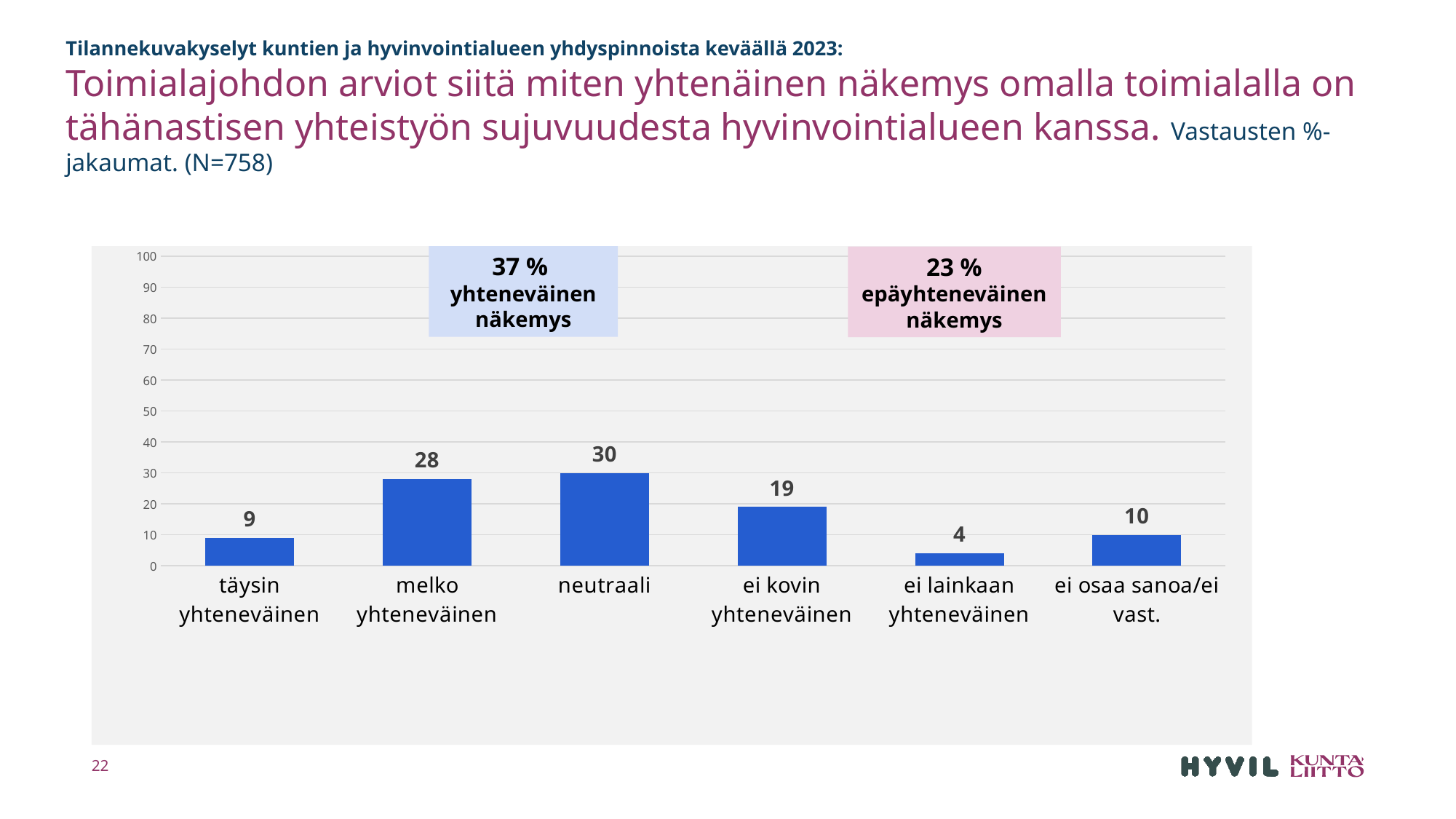
What is the value for "ei osaa sanoa/ei vast."? 10 What percentage does the pink box above the chart give for "epäyhteneväinen näkemys"? 23 % What is the value for "täysin yhteneväinen"? 9 What is the value for "neutraali"? 30 Which category has the lowest value? ei lainkaan yhteneväinen Which is larger, the value for "täysin yhteneväinen" or the value for "ei osaa sanoa/ei vast."? ei osaa sanoa/ei vast. What is the value for "ei kovin yhteneväinen"? 19 What is the difference between the values for "melko yhteneväinen" and "ei kovin yhteneväinen"? 9 Is the value for "melko yhteneväinen" greater or less than 20? greater How many categories are shown on the x axis? 6 What kind of chart is shown on the slide? bar chart Which category has the highest value? neutraali